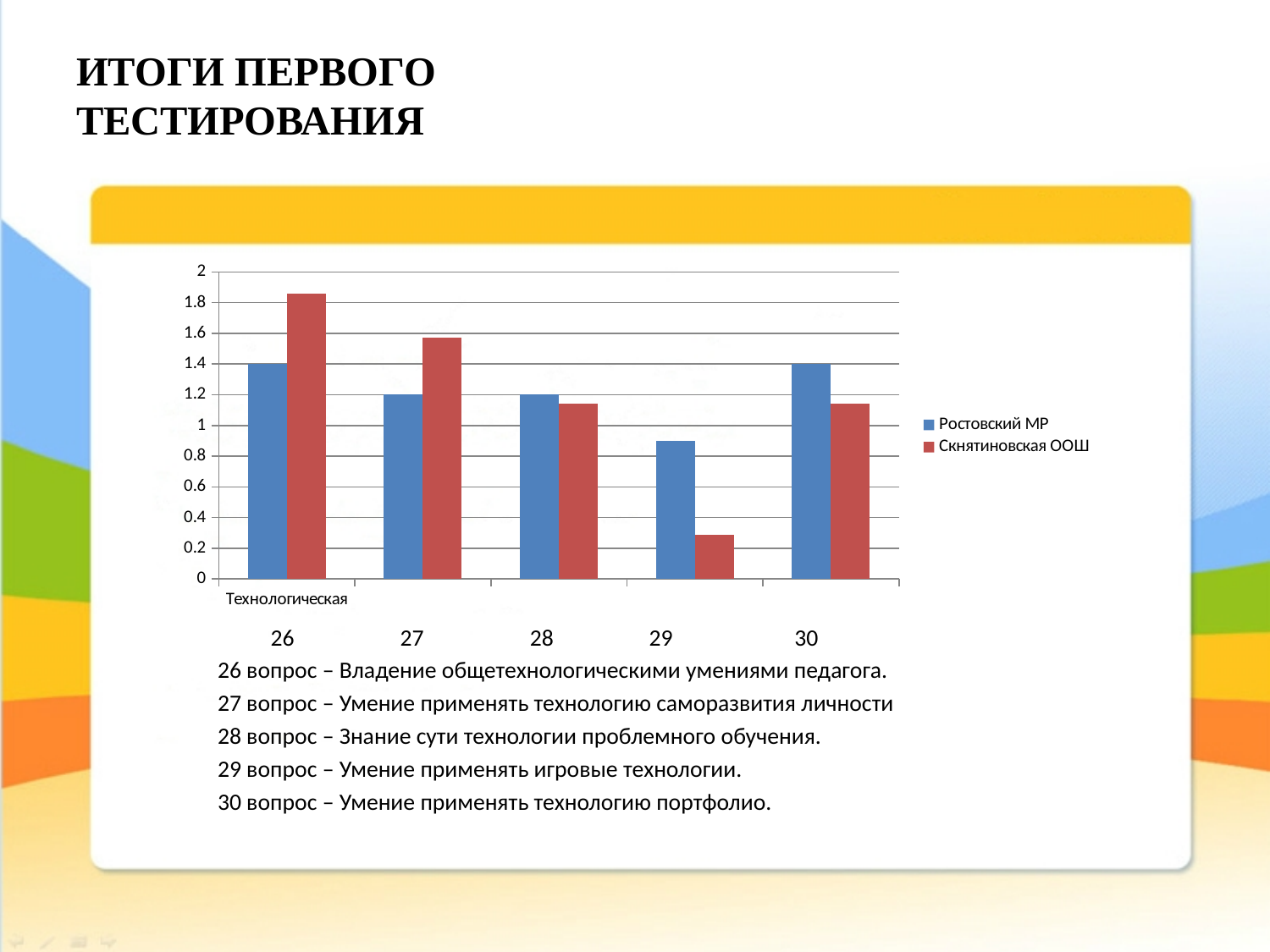
For question 29, which series has the larger value, Ростовский МР or Скнятиновская ООШ? Ростовский МР For which question does Скнятиновская ООШ have its lowest value? 29 Is the value for Скнятиновская ООШ for question 26 greater or less than 1.8? greater What is the value for Ростовский МР for question 30? 1.4 For which question does Скнятиновская ООШ have its highest value? 26 Is the value for Скнятиновская ООШ for question 27 greater or less than 1.4? greater What kind of chart is shown on the slide? bar chart How many question categories (26–30) are plotted on the x axis? 5 How many series does the legend list? 2 Is the value for Скнятиновская ООШ for question 29 greater or less than 0.4? less What is the value for Ростовский МР for question 26? 1.4 What is the value for Ростовский МР for question 27? 1.2